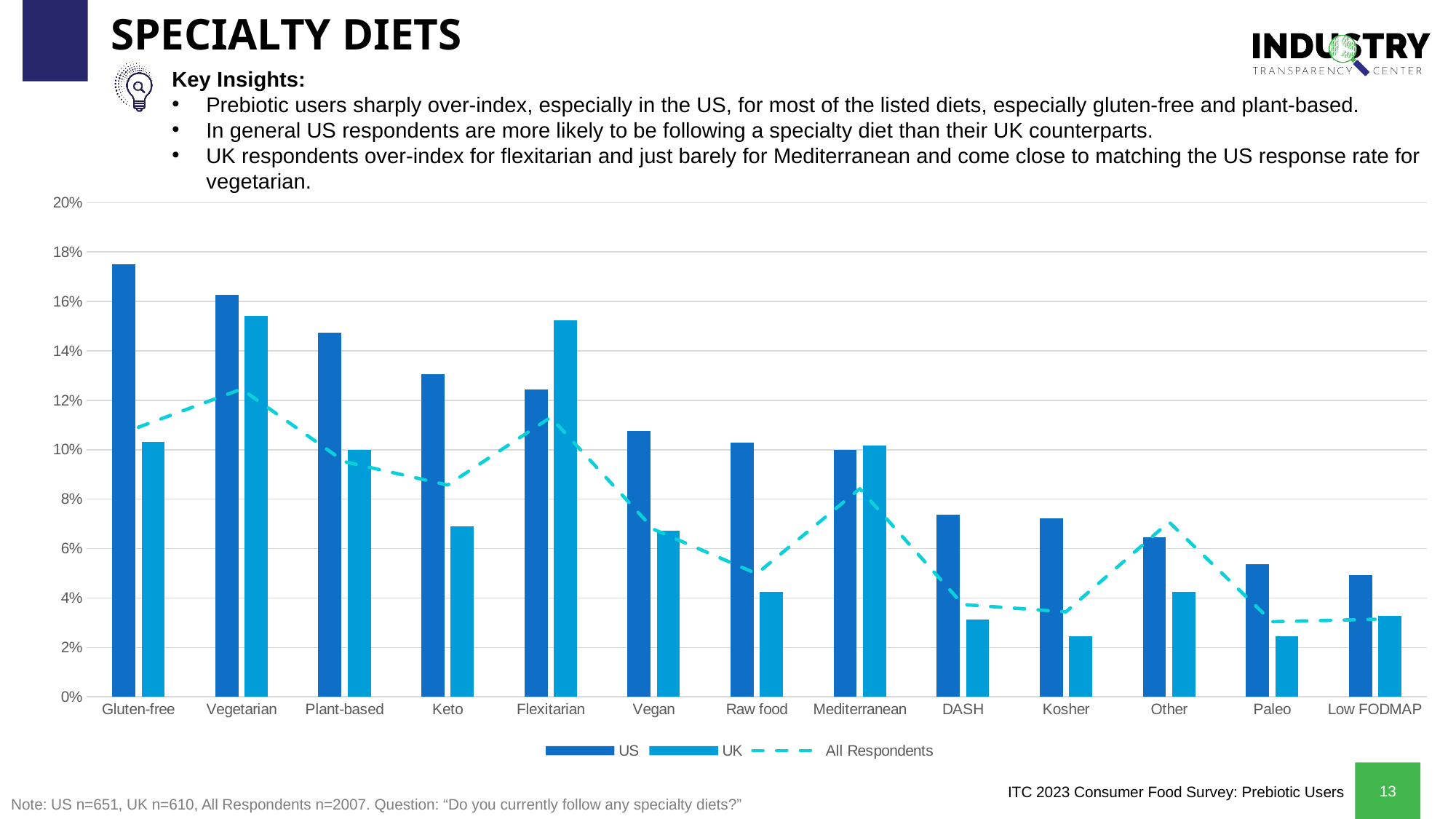
Is the UK value for Raw food greater or less than 6%? less How many diet categories are shown on the x axis? 13 Which series is drawn as a dashed line? All Respondents Do the US values generally rise or fall moving from left to right across the diets? fall Is the UK value for Keto greater or less than 8%? less Which diet has the highest US value? Gluten-free How many series does the legend list? 3 Is the UK value for Flexitarian greater or less than 14%? greater For Keto, which is larger, the US value or the UK value? US What type of chart is shown on the slide? Bar chart with a dashed line For Flexitarian, which is larger, the US value or the UK value? UK